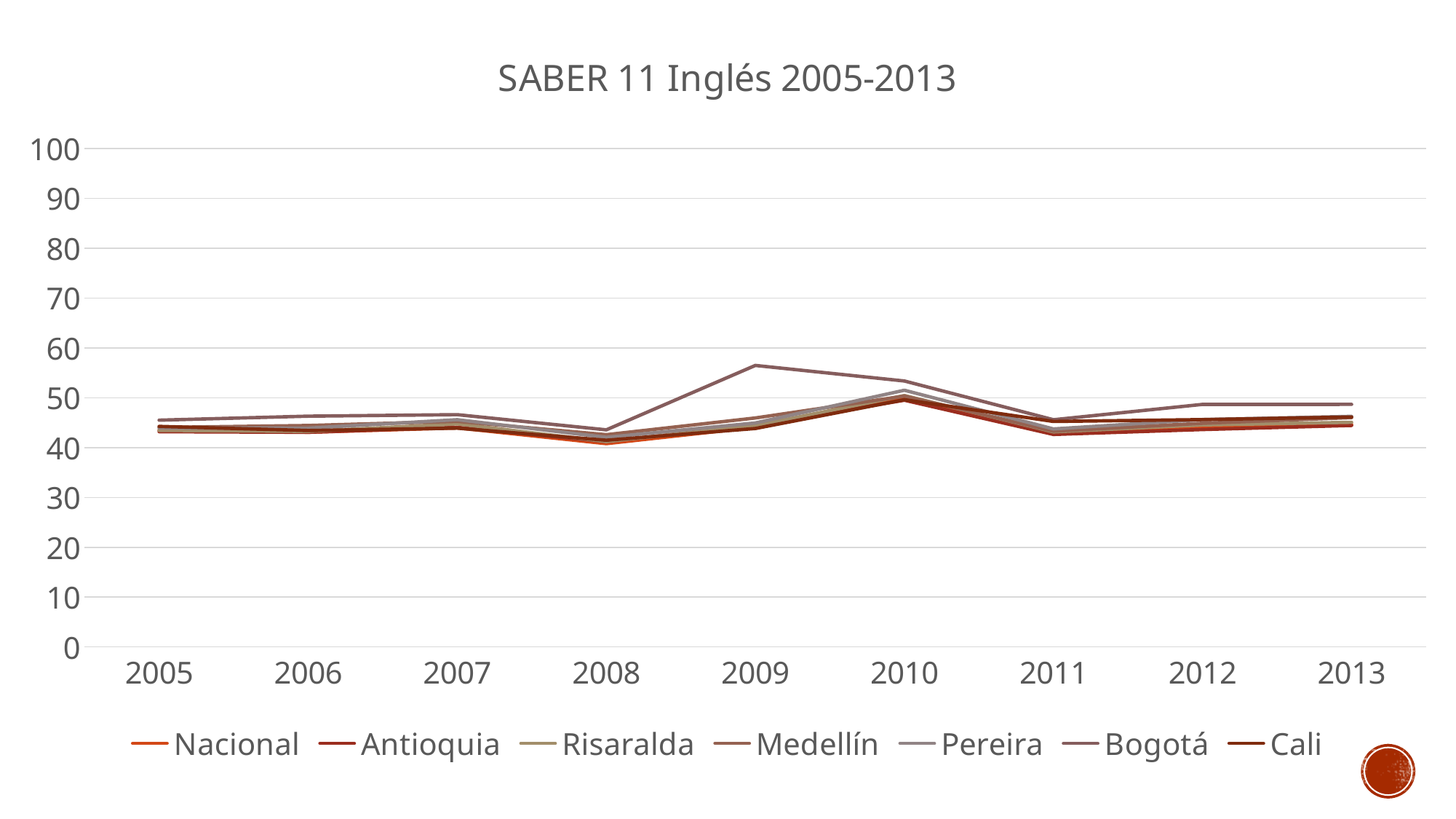
What kind of chart is shown on the slide? line chart Do the lines generally rise or fall between 2008 and 2010? rise Which series is listed first in the legend? Nacional In which year does the lowest value on the chart occur? 2008 Is the highest value plotted in 2009 greater or less than 50? greater How many years are shown along the x axis? 9 Do the lines generally rise or fall between 2010 and 2011? fall How many series does the legend list? 7 In which year does the highest value on the chart occur? 2009 What is the title of the chart? SABER 11 Inglés 2005-2013 Are all values plotted in 2005 greater or less than 60? less Is the lowest value plotted in 2008 greater or less than 50? less